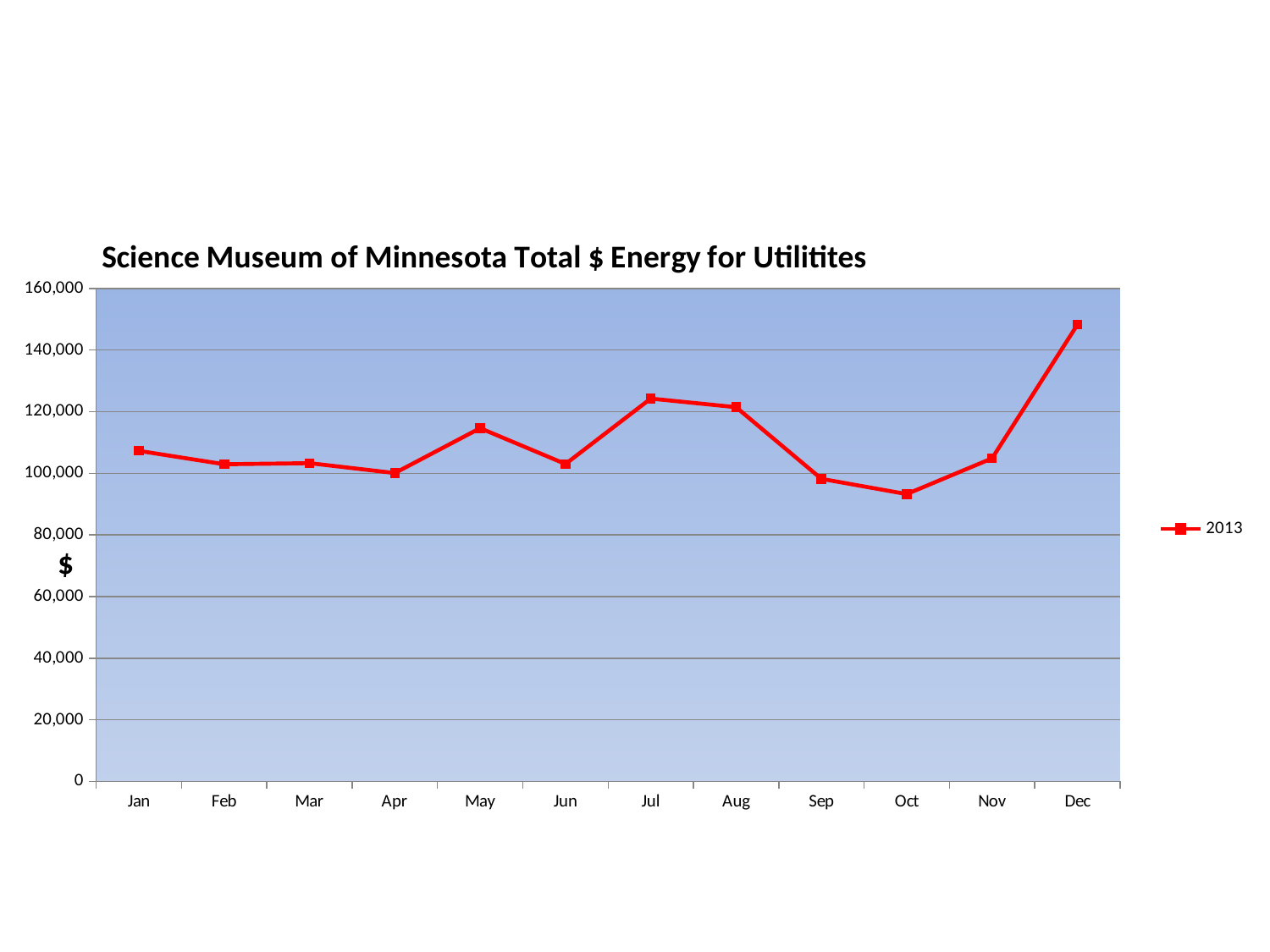
Is the value for Dec greater or less than 140,000? greater Which month has the lowest value? Oct Which is larger, the value for Jul or the value for Jun? Jul What kind of chart is shown on the slide? line chart What series name appears in the legend? 2013 How many series does the legend list? 1 How many months are plotted along the x axis? 12 What is the title of the chart? Science Museum of Minnesota Total $ Energy for Utilitites Is the value for Oct greater or less than 100,000? less Is the value for Jul greater or less than 120,000? greater Do the values rise or fall from Oct to Dec? rise Which month has the highest value? Dec